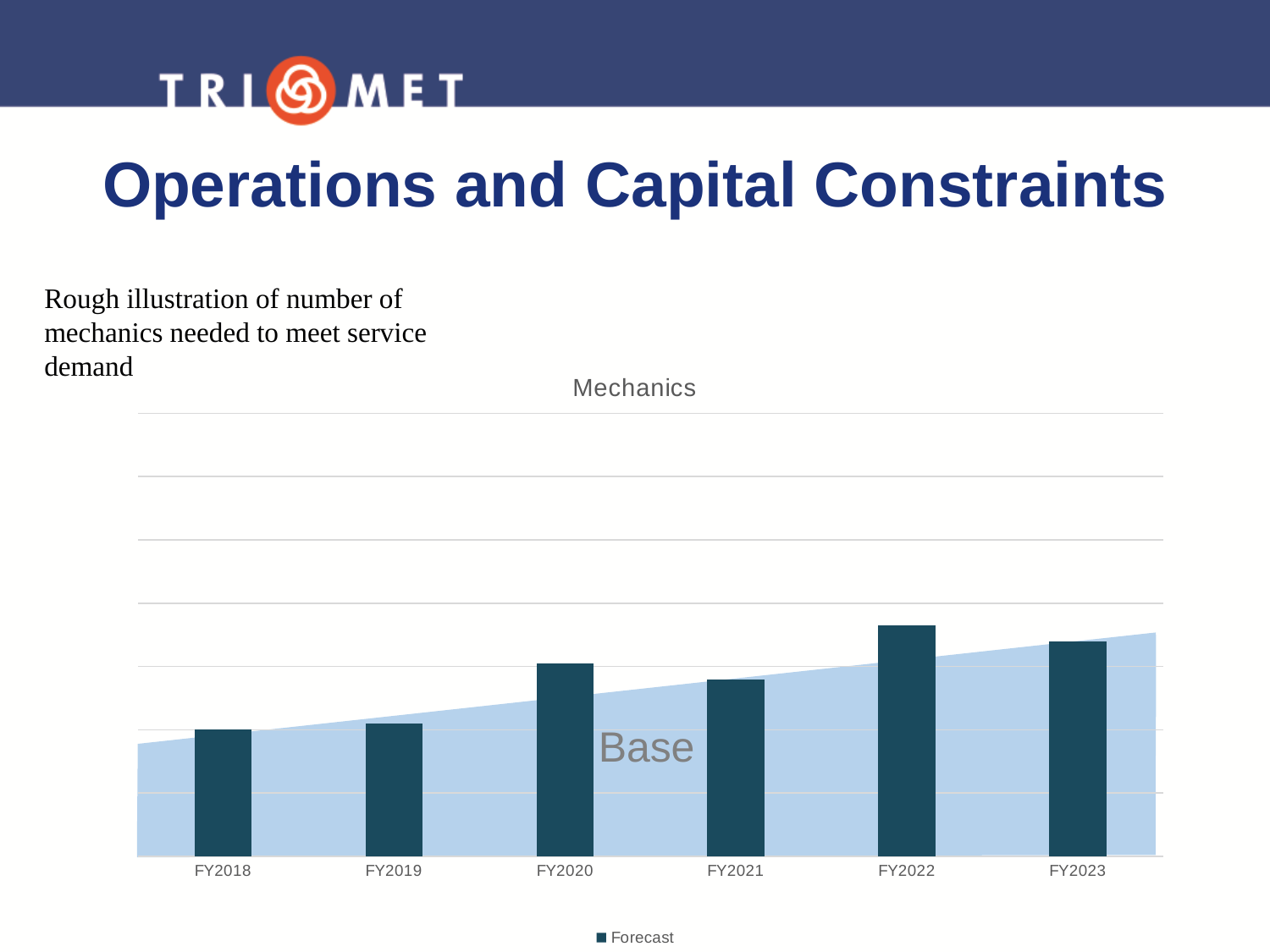
Which is larger, the Forecast value for FY2022 or for FY2023? FY2022 What is the first fiscal year shown on the x axis? FY2018 Does the shaded Base area rise or fall from FY2018 to FY2023? rise How many fiscal years are shown on the x axis of the chart? 6 Which fiscal year has the highest Forecast bar? FY2022 Do the Forecast bars generally rise or fall from FY2018 to FY2023? rise What series name appears in the chart's legend? Forecast What kind of chart is used to show the Forecast series? bar chart Which is larger, the Forecast value for FY2018 or for FY2020? FY2020 What is the title of the chart? Mechanics Is the Forecast bar for FY2020 taller or shorter than the bar for FY2021? taller How many series does the chart's legend list? 1